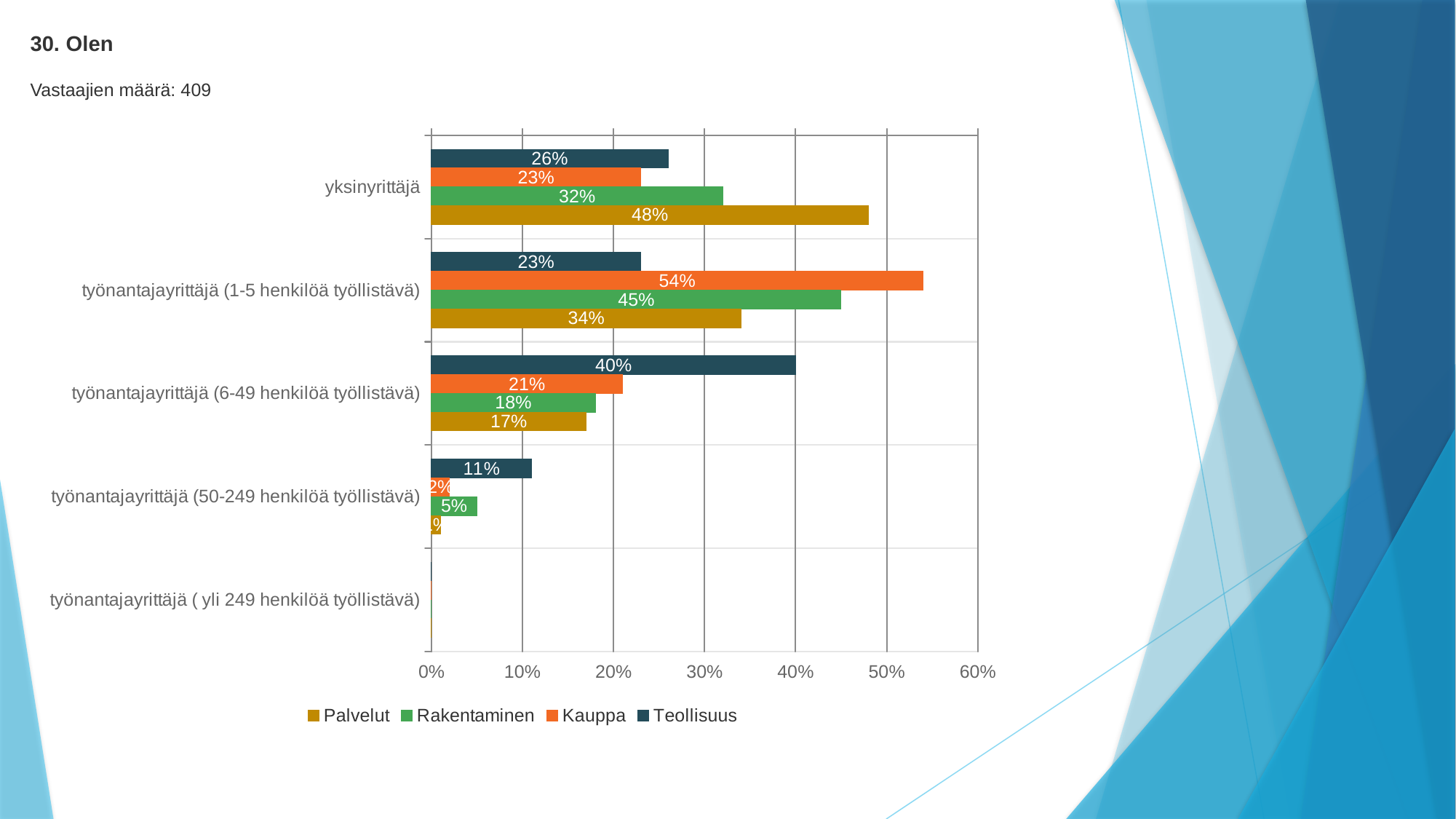
What is the value for Kauppa in the työnantajayrittäjä (1-5 henkilöä työllistävä) category? 54% How many categories are shown on the vertical axis? 5 What kind of chart is shown on the slide? bar chart What is the value for Palvelut in the yksinyrittäjä category? 48% Which is larger in the työnantajayrittäjä (50-249 henkilöä työllistävä) category: Teollisuus or Rakentaminen? Teollisuus Which series has the highest value in the yksinyrittäjä category? Palvelut What is the difference between the Rakentaminen and Kauppa values in the yksinyrittäjä category? 9% What is the number of respondents (Vastaajien määrä) stated on the slide? 409 What is the value for Teollisuus in the työnantajayrittäjä (6-49 henkilöä työllistävä) category? 40% Is the value for Rakentaminen in the työnantajayrittäjä (1-5 henkilöä työllistävä) category greater or less than 40%? greater How many series does the legend list? 4 Which series has the lowest value in the työnantajayrittäjä (1-5 henkilöä työllistävä) category? Teollisuus